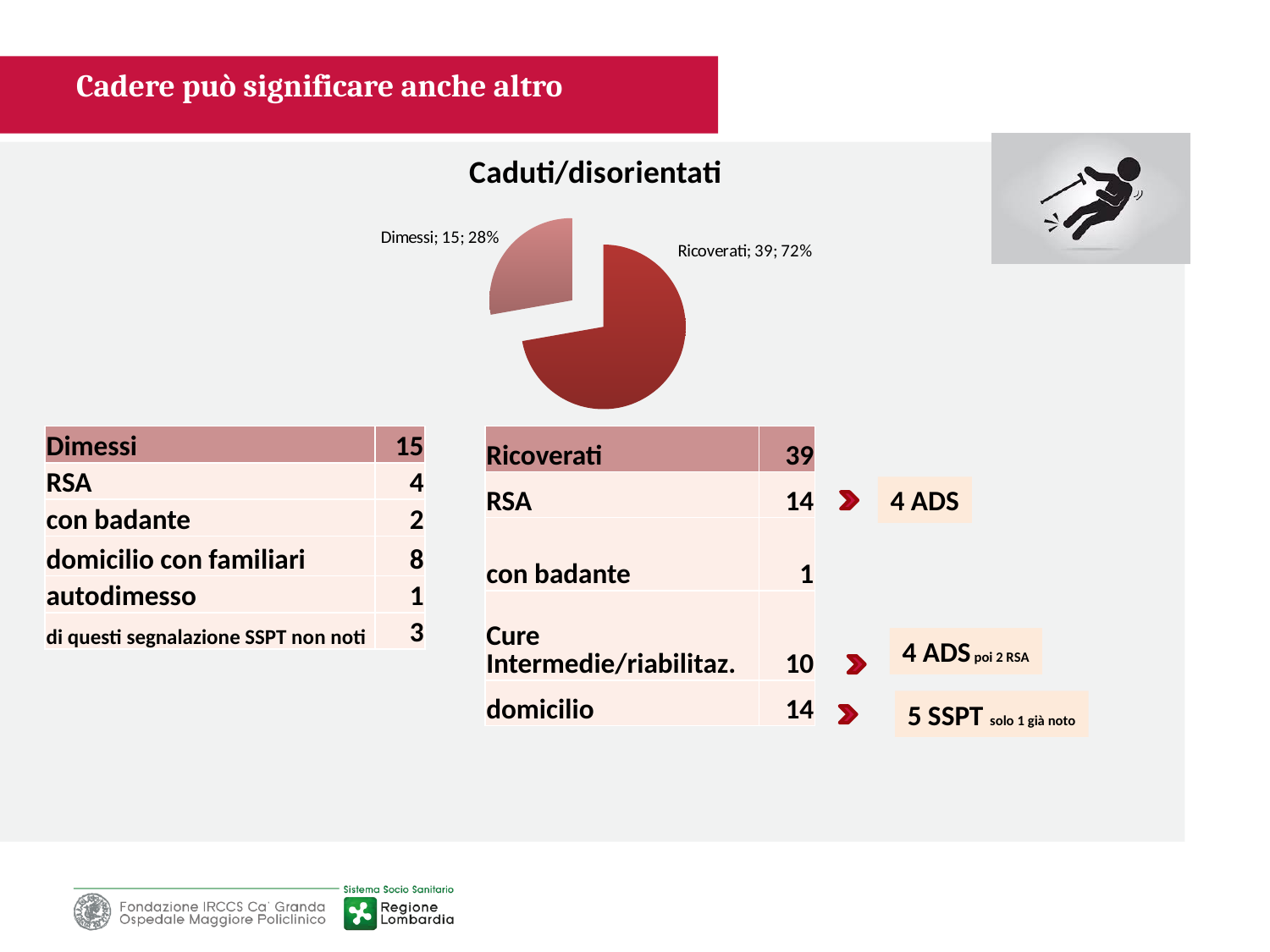
What is the total of the two slices in the pie chart? 54 Which is larger in the pie chart, Dimessi or Ricoverati? Ricoverati What is the value for Dimessi in the pie chart? 15 Which slice of the pie chart is the smallest? Dimessi How many slices does the pie chart have? 2 What is the title of the pie chart? Caduti/disorientati What is the difference between the Ricoverati and Dimessi values in the pie chart? 24 Which slice of the pie chart is the largest? Ricoverati What share of the pie does the Dimessi slice represent? 28% What share of the pie does the Ricoverati slice represent? 72% What is the value for Ricoverati in the pie chart? 39 What kind of chart is shown on the slide? pie chart